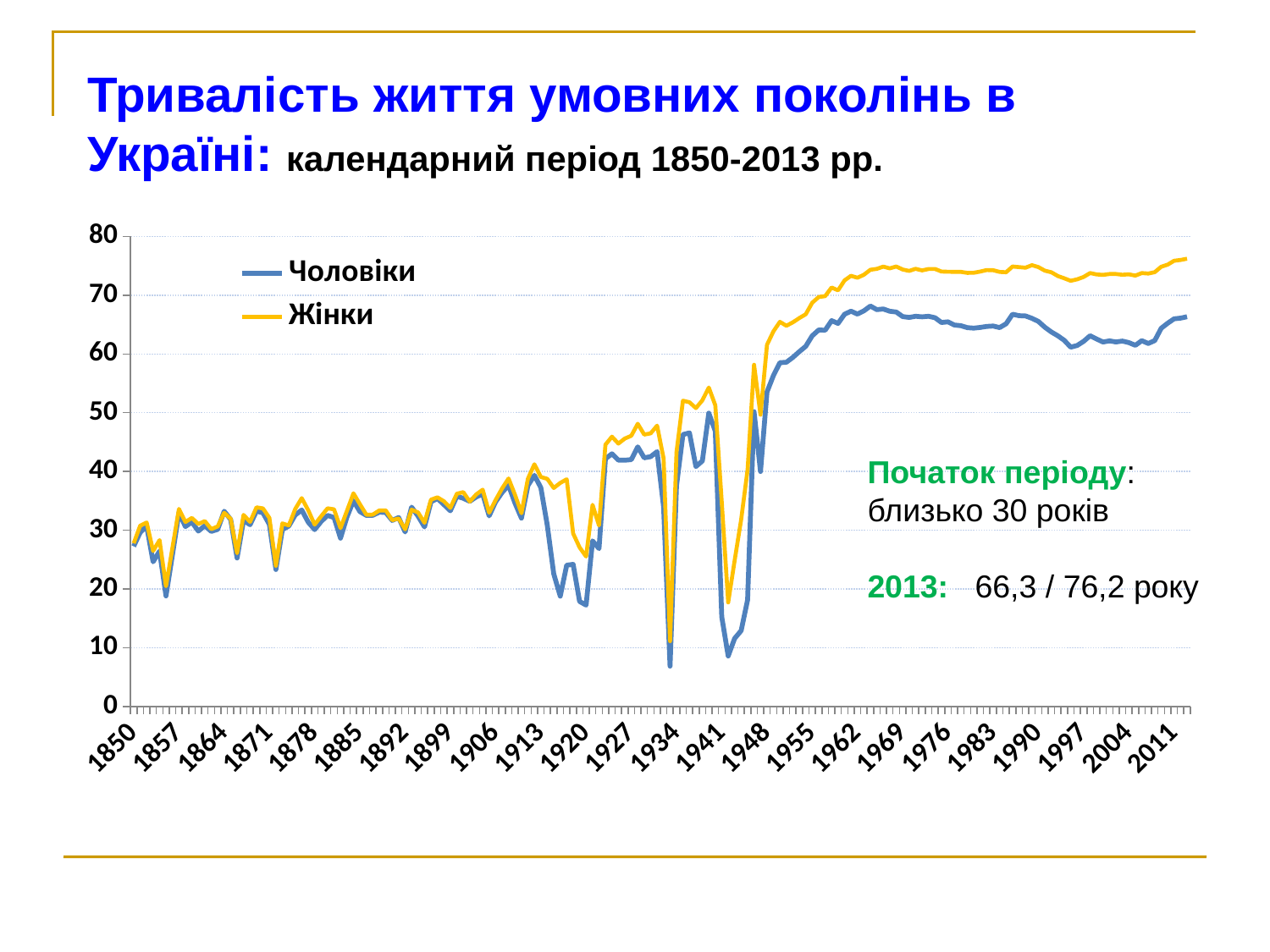
Is the value for Чоловіки around 1933 greater or less than 10? less Is the value for Жінки around 1969 greater or less than 70? greater Do the values for both series rise or fall between 1948 and 1962? rise Which series is drawn in yellow? Жінки According to the text on the slide, what is the life expectancy for men in 2013? 66,3 How many series does the legend list? 2 Which series has the higher value in 2013, Чоловіки or Жінки? Жінки What kind of chart is shown on the slide? line chart According to the text on the slide, what is the life expectancy for women in 2013? 76,2 What are the two series named in the legend? Чоловіки and Жінки Does the value for Чоловіки rise or fall between 1990 and 1997? fall